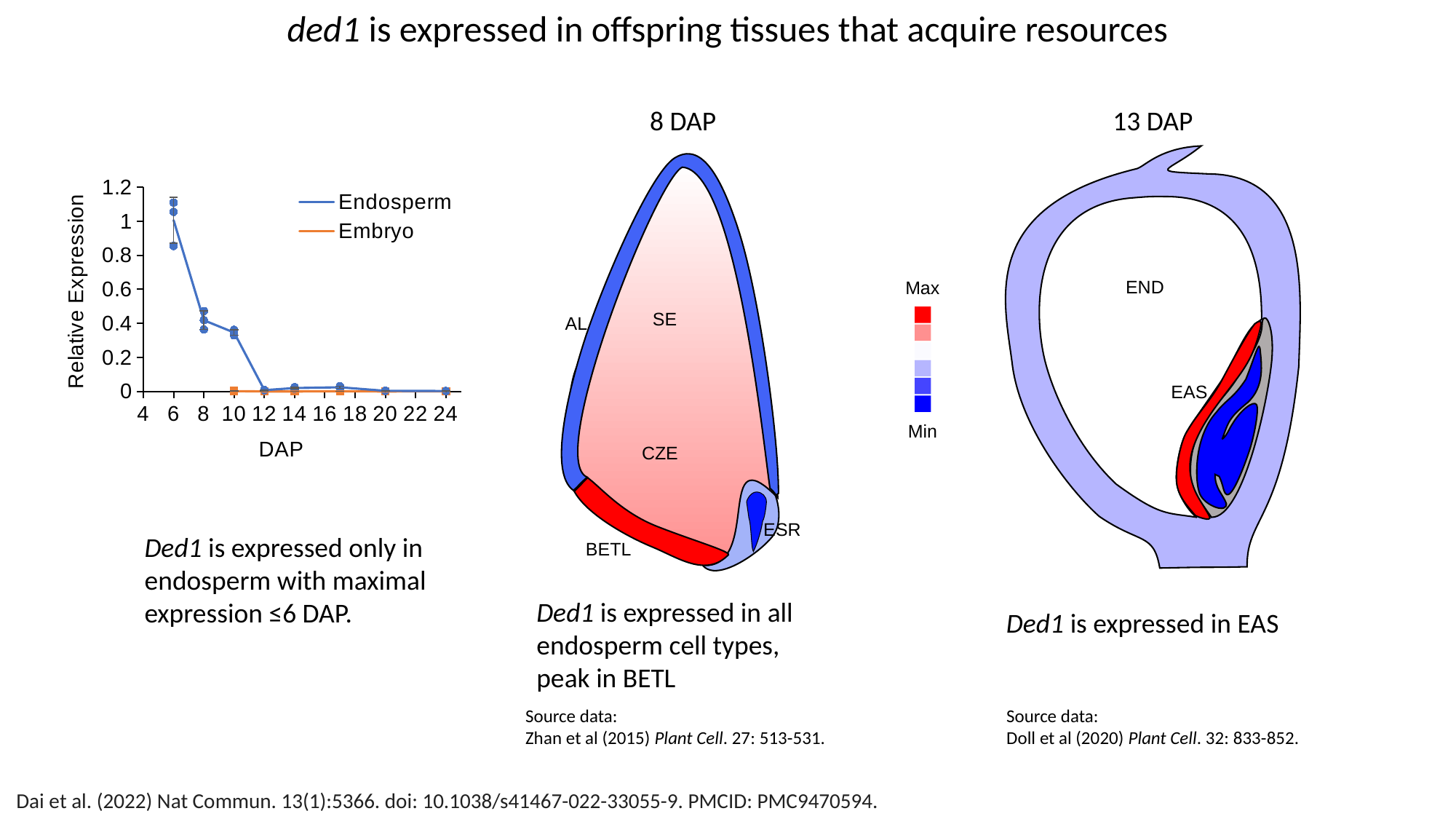
In the line chart, which series has the larger value at 6 DAP, Endosperm or Embryo? Endosperm In the line chart, at which DAP is Endosperm relative expression highest? 6 How many series does the legend of the line chart list? 2 What is the y-axis label of the line chart? Relative Expression In the line chart, is the Endosperm value at 10 DAP greater or less than 0.2? greater In the line chart, is the Endosperm value at 6 DAP greater or less than 0.8? greater What kind of chart is shown on the left of the slide? line chart What is the highest tick value shown on the y-axis of the line chart? 1.2 In the line chart, is the Endosperm value at 12 DAP greater or less than 0.2? less In the line chart, does the Endosperm series rise or fall as DAP increases? fall Which two series are listed in the legend of the line chart? Endosperm and Embryo